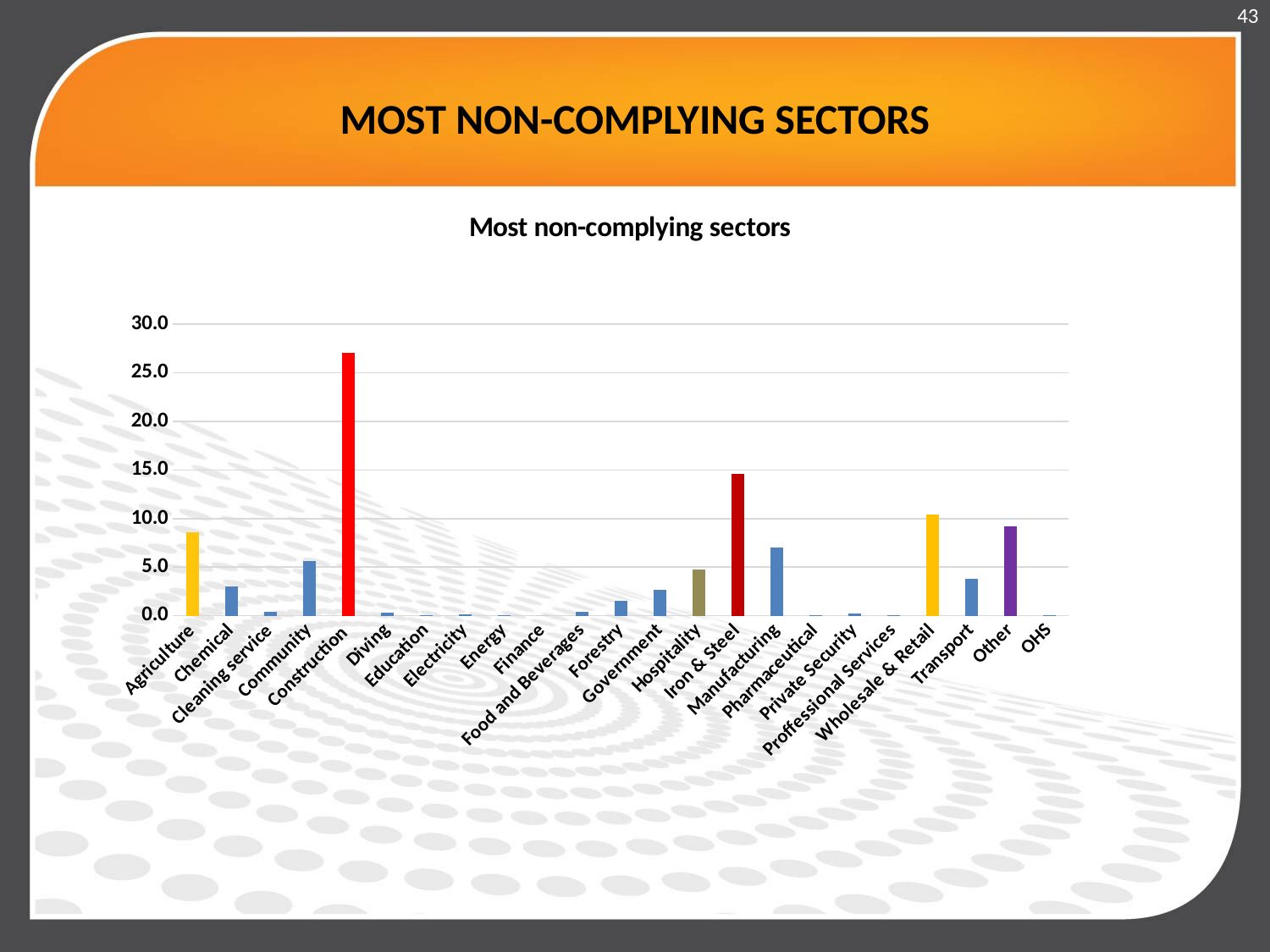
Which has a larger value, Construction or Iron & Steel? Construction Which sector has the highest bar in the chart? Construction Is the value for Construction greater or less than 25.0? greater Is the value for Chemical greater or less than 5.0? less Is the value for Iron & Steel greater or less than 10.0? greater What is the title of the chart? Most non-complying sectors What colour is the bar for Construction? red Which has a larger value, Manufacturing or Transport? Manufacturing What kind of chart is shown on the slide? bar chart How many sectors are shown along the x axis of the chart? 23